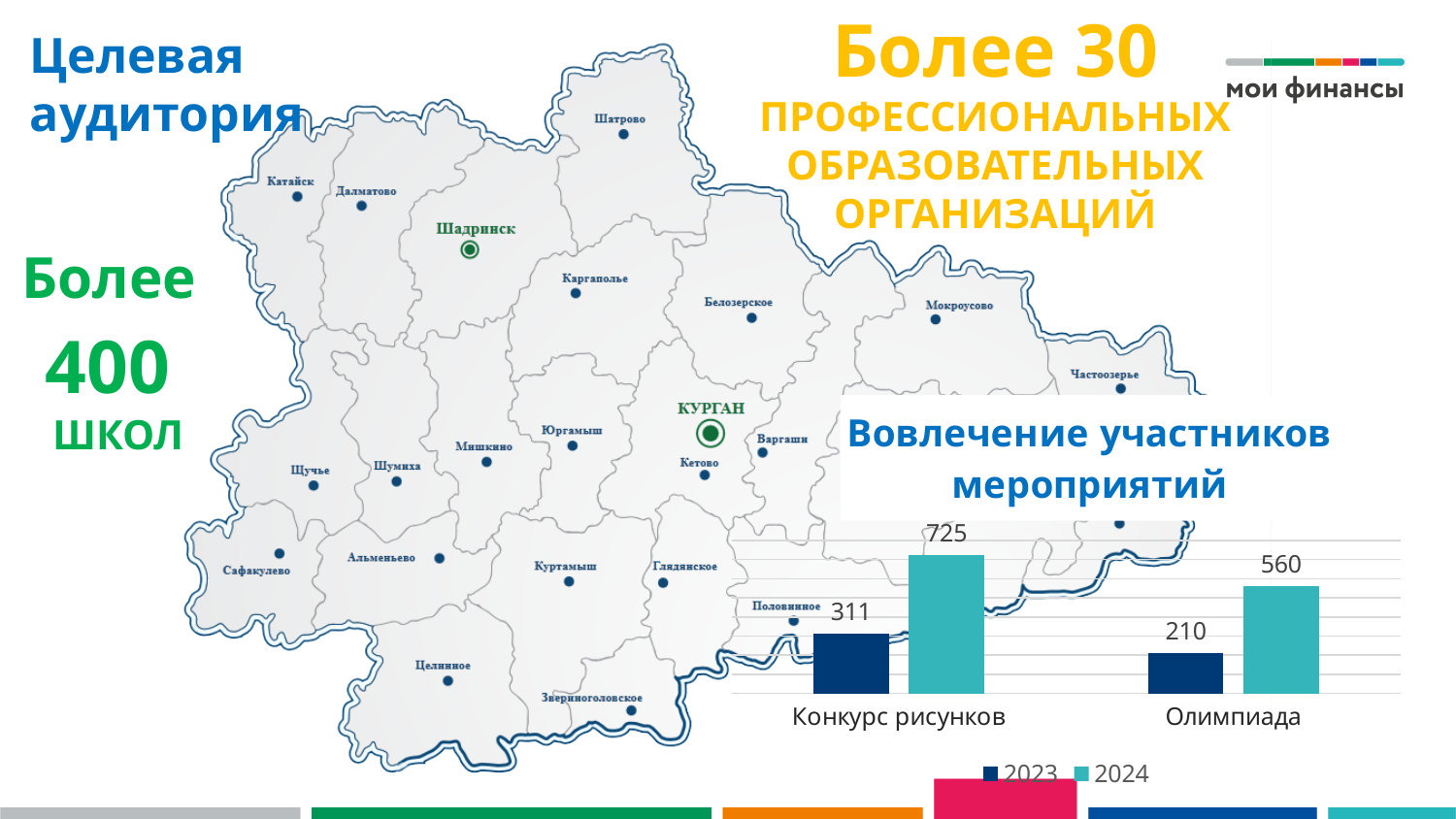
What is the difference between the 2024 and 2023 values for Олимпиада? 350 What is the value for 2023 in the Олимпиада category? 210 What is the value for 2024 in the Олимпиада category? 560 How many categories are shown on the x axis of the chart? 2 Which category has the highest value for the 2024 series? Конкурс рисунков How many series does the chart legend list? 2 Which is larger: the 2023 value for Конкурс рисунков or the 2024 value for Олимпиада? 2024 value for Олимпиада What is the value for 2023 in the Конкурс рисунков category? 311 Which category has the lowest value for the 2023 series? Олимпиада What is the difference between the 2024 and 2023 values for Конкурс рисунков? 414 What type of chart is used to show participant involvement? Bar chart What is the value for 2024 in the Конкурс рисунков category? 725